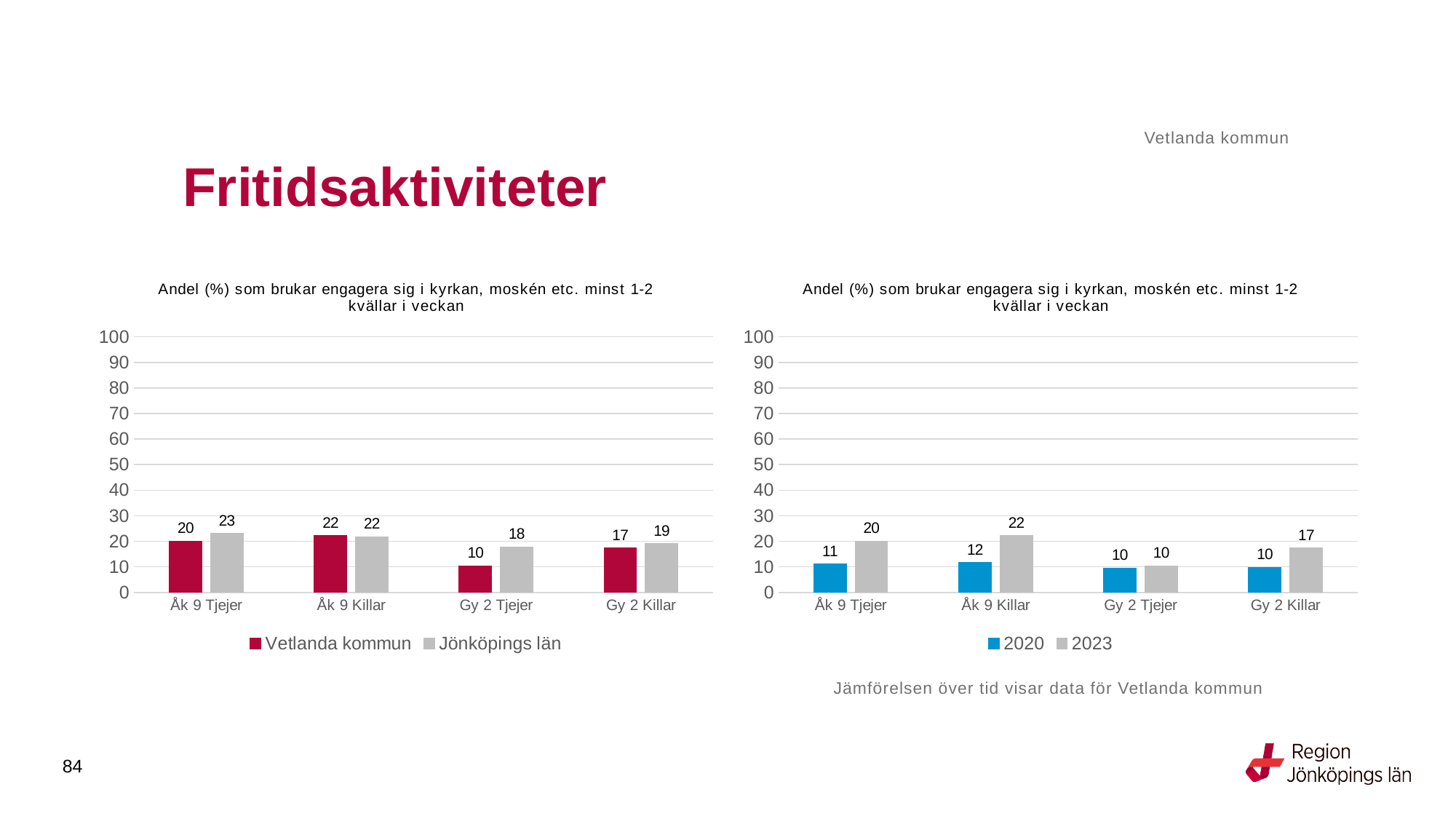
In the right chart, what is the value for 2023 for Gy 2 Killar? 17 In the left chart, how many series does the legend list? 2 What kind of chart is the left chart? Bar chart How many categories are shown on the x axis of the right chart? 4 In the right chart, which category has the highest value for 2023? Åk 9 Killar In the left chart, what is the value for Vetlanda kommun for Gy 2 Tjejer? 10 In the left chart, which category has the lowest value for Vetlanda kommun? Gy 2 Tjejer In the right chart, what is the difference between 2023 and 2020 for Åk 9 Killar? 10 In the left chart, what is the difference between Jönköpings län and Vetlanda kommun for Gy 2 Tjejer? 8 In the left chart, what is the value for Jönköpings län for Åk 9 Tjejer? 23 In the right chart, what is the value for 2020 for Åk 9 Killar? 12 In the right chart, which is larger for Åk 9 Tjejer: 2020 or 2023? 2023